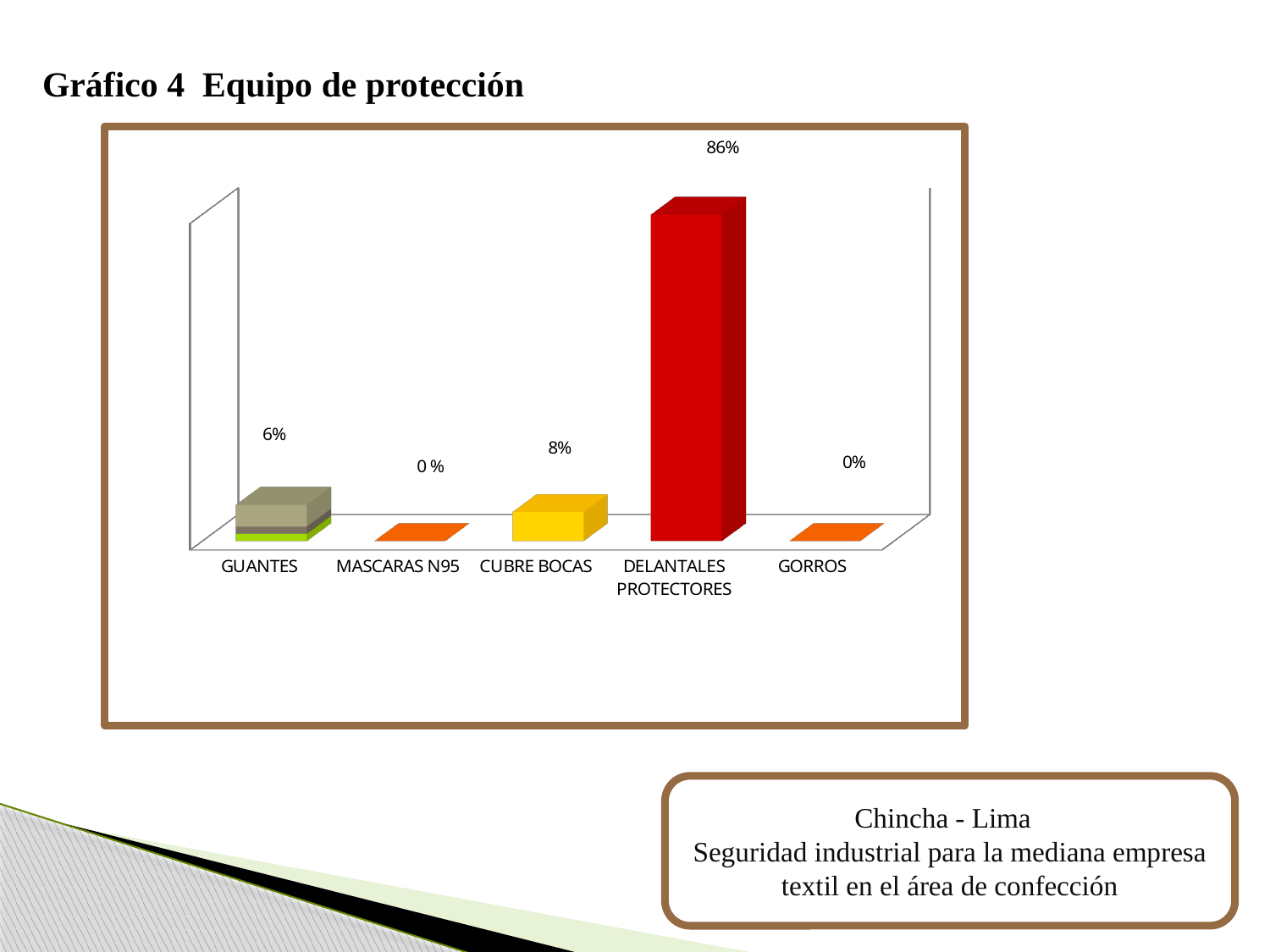
What kind of chart is shown on the slide? Bar chart What is the value for GUANTES? 6% What is the value for MASCARAS N95? 0 % Which category has the highest value? DELANTALES PROTECTORES What is the value for GORROS? 0% What is the difference between the values for CUBRE BOCAS and GUANTES? 2% Which is larger, the value for GUANTES or the value for CUBRE BOCAS? CUBRE BOCAS What is the title of the chart? Gráfico 4 Equipo de protección What is the difference between the values for DELANTALES PROTECTORES and CUBRE BOCAS? 78% What is the value for DELANTALES PROTECTORES? 86% How many categories are shown on the x axis? 5 What is the value for CUBRE BOCAS? 8%